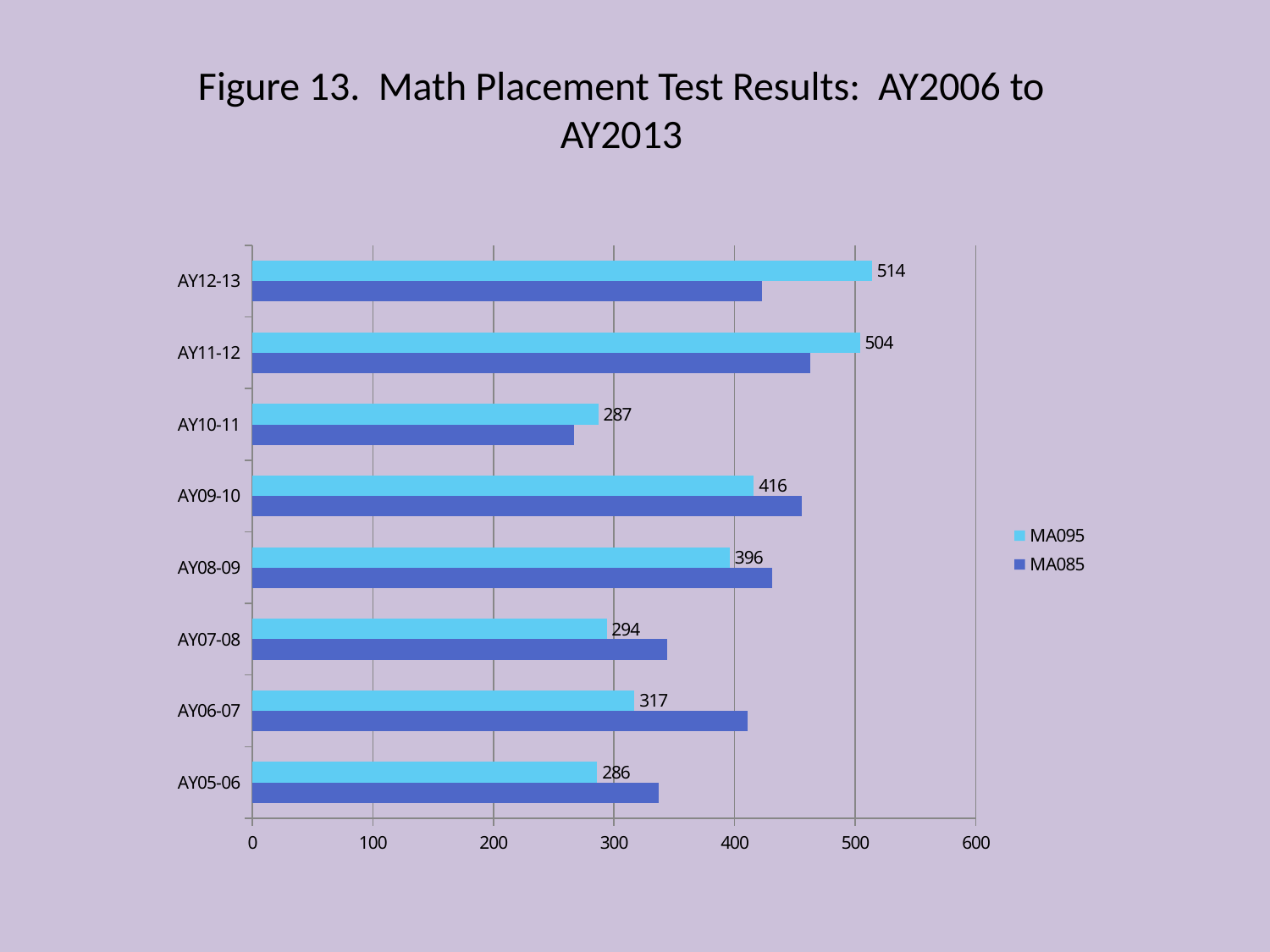
What is the difference between the MA095 values for AY12-13 and AY11-12? 10 What is the MA095 value for AY08-09? 396 Which academic year has the highest MA095 value? AY12-13 Is the MA085 value for AY10-11 greater or less than 300? less What is the difference between the MA095 values for AY09-10 and AY08-09? 20 Which is larger, the MA095 value for AY11-12 or for AY10-11? AY11-12 Is the MA085 value for AY12-13 greater or less than 400? greater How many academic years are shown on the chart? 8 How many series does the legend list? 2 What is the MA095 value for AY05-06? 286 What is the MA095 value for AY12-13? 514 What kind of chart is shown on the slide? Bar chart